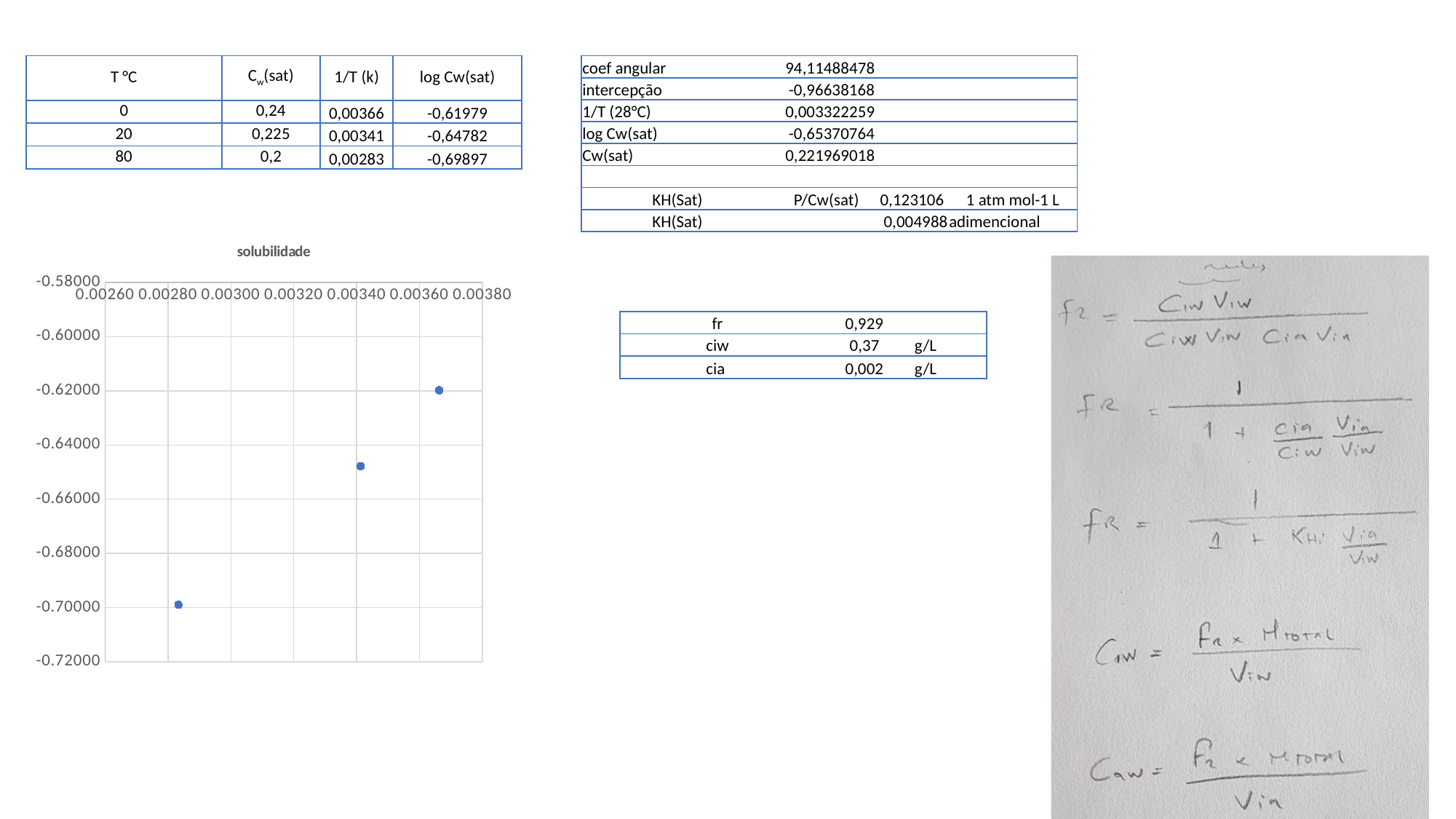
Which point has the lowest y value in the chart? the leftmost point (near x = 0.00280) What kind of chart is shown on the slide? scatter chart Is the y value of the middle point (near x = 0.00340) greater or less than -0.62000? less Do the plotted values rise or fall as the x-axis value increases? rise How many data points are plotted in the chart? 3 What is the title of the chart? solubilidade Is the y value of the leftmost point (near x = 0.00280) greater or less than -0.68000? less What is the lowest value shown on the y axis? -0.72000 Is the y value of the middle point (near x = 0.00340) greater or less than -0.66000? greater Which point has the highest y value: the leftmost or the rightmost? the rightmost